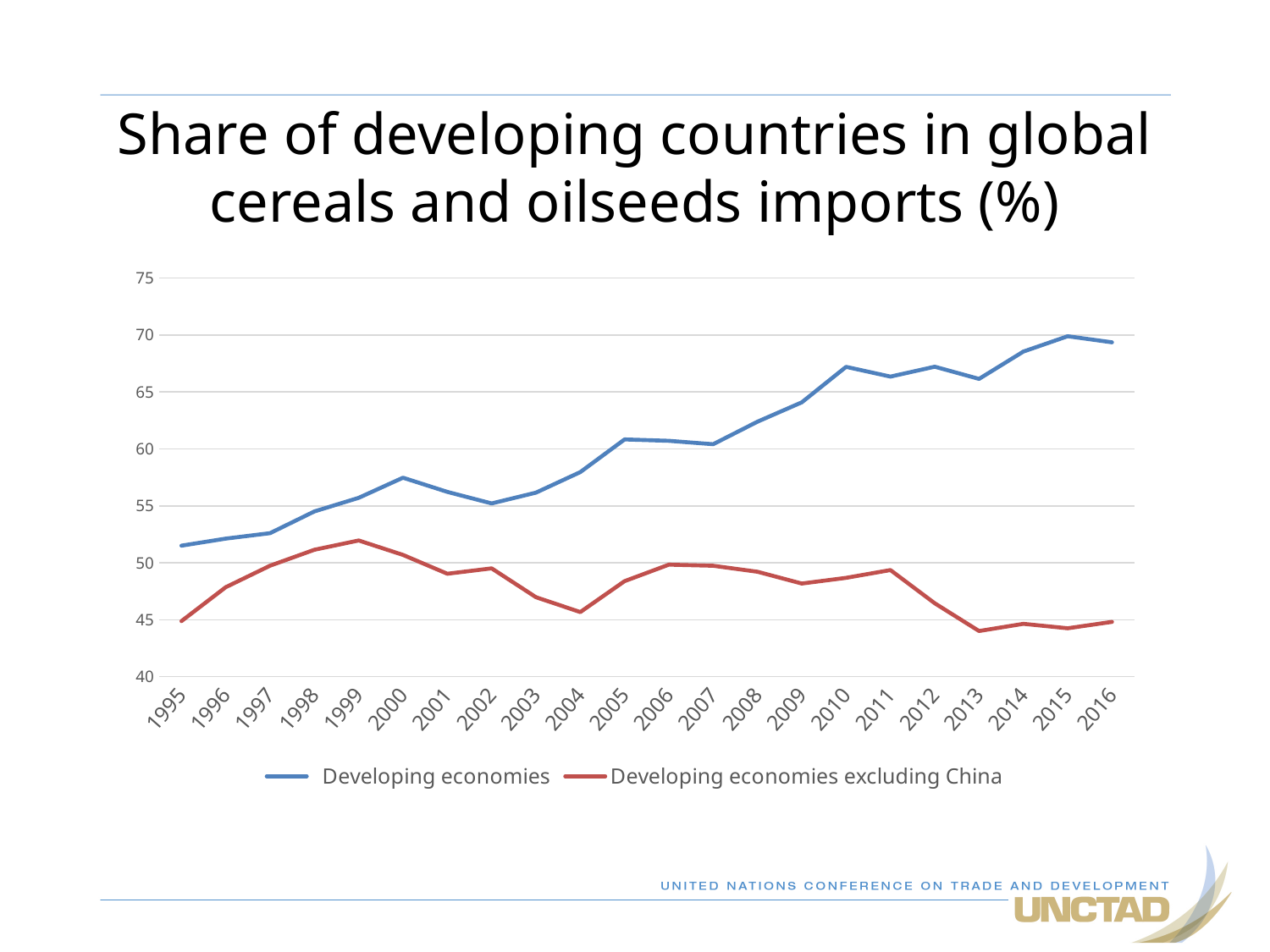
For the Developing economies series, which year has the larger value, 2000 or 2002? 2000 Is the value for Developing economies excluding China in 1999 greater or less than 50? greater In which year is the Developing economies series at its lowest? 1995 Does the Developing economies series generally rise or fall from 1995 to 2016? Rise How many series does the legend list? 2 What kind of chart is shown on the slide? Line chart In which year does the Developing economies excluding China series reach its highest value? 1999 How many years are plotted along the x axis? 22 Is the value for Developing economies in 2010 greater or less than 65? greater What is the title of the chart? Share of developing countries in global cereals and oilseeds imports (%) Is the value for Developing economies excluding China in 2004 greater or less than 50? less Which series is drawn in blue? Developing economies